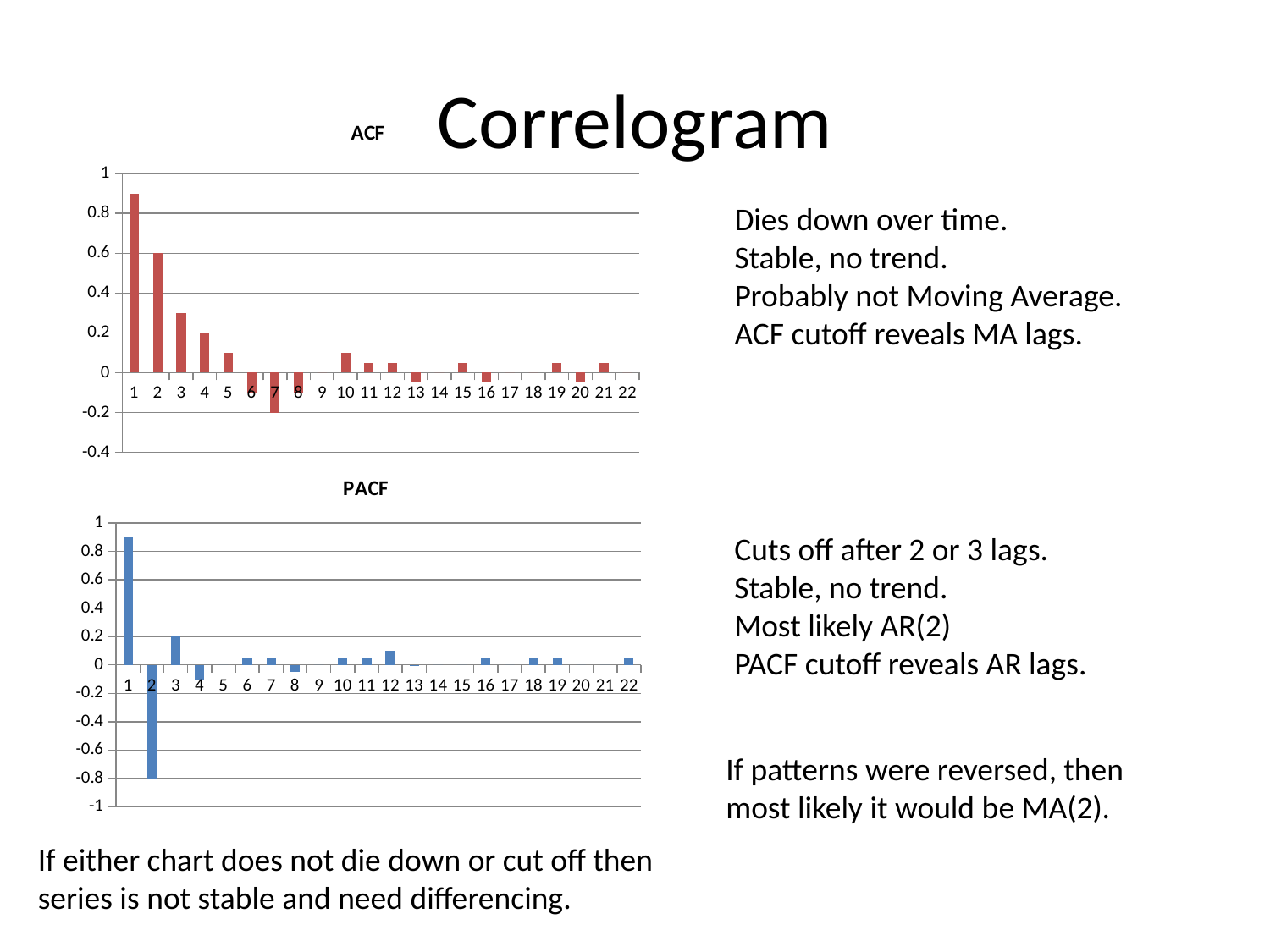
In the ACF chart, what is the value for lag 2? 0.6 In the ACF chart, do the values generally rise or fall over the first five lags? fall How many lags are shown on the x axis of the ACF chart? 22 What type of chart is the ACF chart? bar chart In the ACF chart, is the value for lag 3 greater or less than 0.2? greater In the PACF chart, is the value for lag 2 greater or less than -0.6? less In the PACF chart, which lag has the highest value? 1 In the PACF chart, which is larger, the value for lag 1 or the value for lag 3? lag 1 In the ACF chart, which lag has the lowest value? 7 In the PACF chart, which lag has the lowest value? 2 In the ACF chart, is the value for lag 1 greater or less than 0.8? greater In the ACF chart, which lag has the highest value? 1